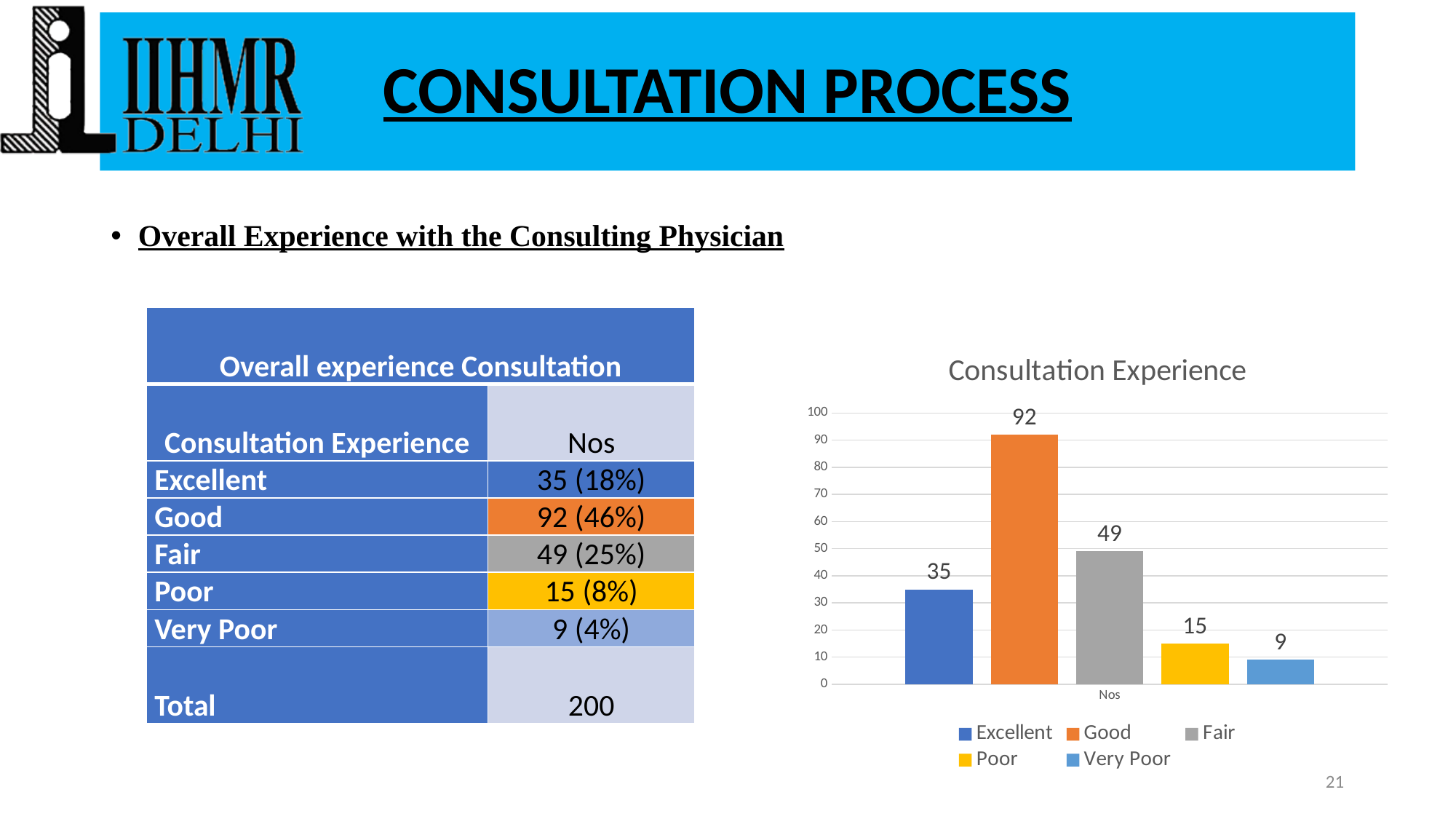
What kind of chart is the Consultation Experience chart? bar chart What is the difference between the Fair and Poor values in the Consultation Experience chart? 34 What is the value for Good in the Consultation Experience chart? 92 What is the difference between the Good and Excellent values in the Consultation Experience chart? 57 Which is larger in the Consultation Experience chart, Excellent or Fair? Fair What is the value for Very Poor in the Consultation Experience chart? 9 Which series has the lowest value in the Consultation Experience chart? Very Poor Which series has the highest value in the Consultation Experience chart? Good How many series does the legend of the Consultation Experience chart list? 5 Is the value for Excellent in the Consultation Experience chart greater or less than 40? less What is the value for Fair in the Consultation Experience chart? 49 What is the title of the chart on the slide? Consultation Experience